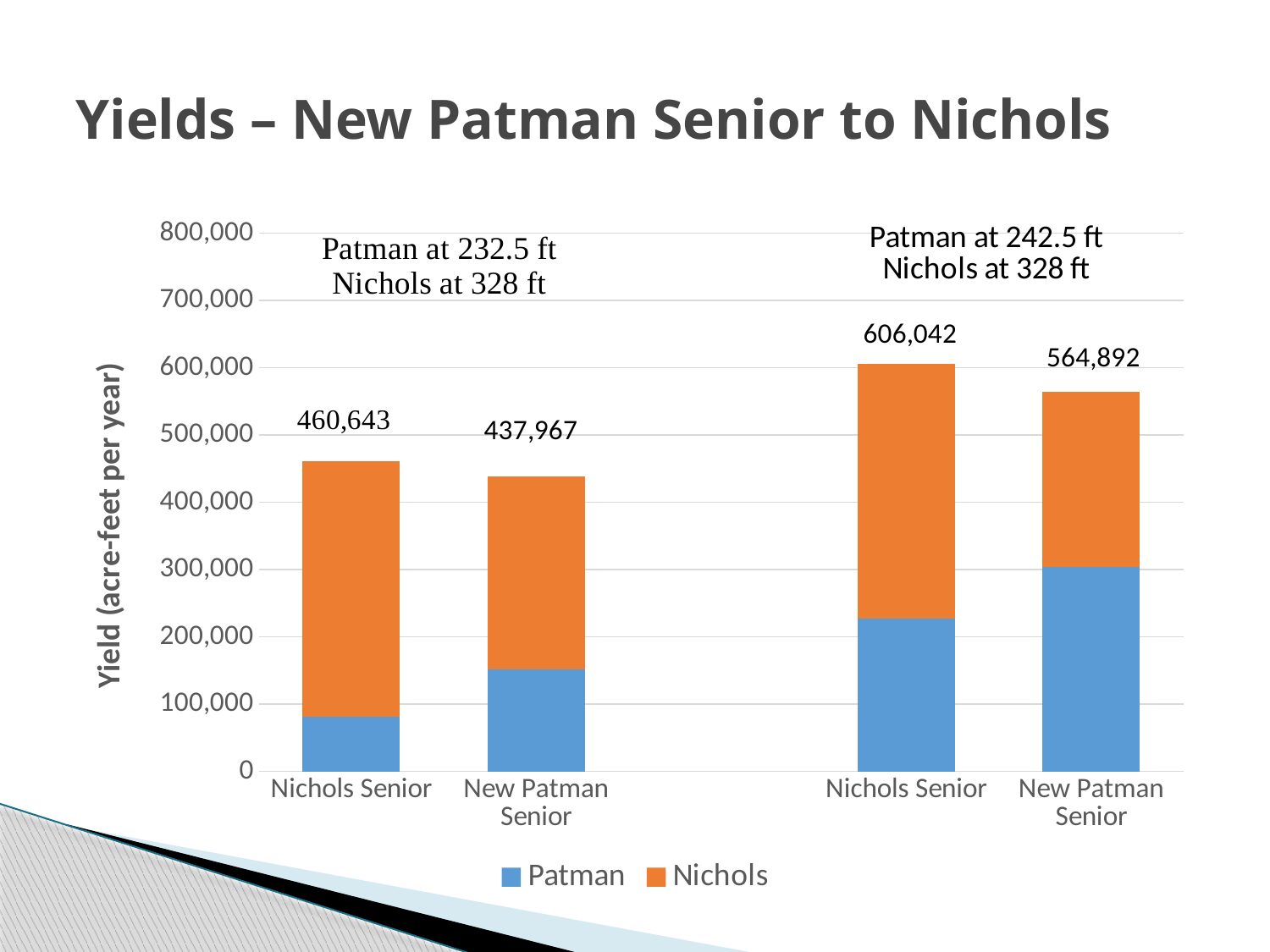
What kind of chart is shown on the slide? Stacked bar chart In the Patman at 232.5 ft scenario, what is the difference between the Nichols Senior total and the New Patman Senior total? 22,676 Which is larger: the New Patman Senior total at Patman 242.5 ft or the Nichols Senior total at Patman 232.5 ft? New Patman Senior at Patman 242.5 ft In the Patman at 242.5 ft scenario, what is the difference between the Nichols Senior total and the New Patman Senior total? 41,150 Is the Patman portion of the Nichols Senior bar in the Patman at 232.5 ft scenario greater or less than 100,000? less How many series does the legend list? 2 What is the total yield for Nichols Senior in the scenario with Patman at 232.5 ft and Nichols at 328 ft? 460,643 Which bar has the lowest total yield? New Patman Senior (Patman at 232.5 ft) What is the total yield for Nichols Senior in the scenario with Patman at 242.5 ft? 606,042 Which bar has the highest total yield? Nichols Senior (Patman at 242.5 ft) How many bars are plotted on the chart? 4 What is the total yield for New Patman Senior in the scenario with Patman at 242.5 ft and Nichols at 328 ft? 564,892